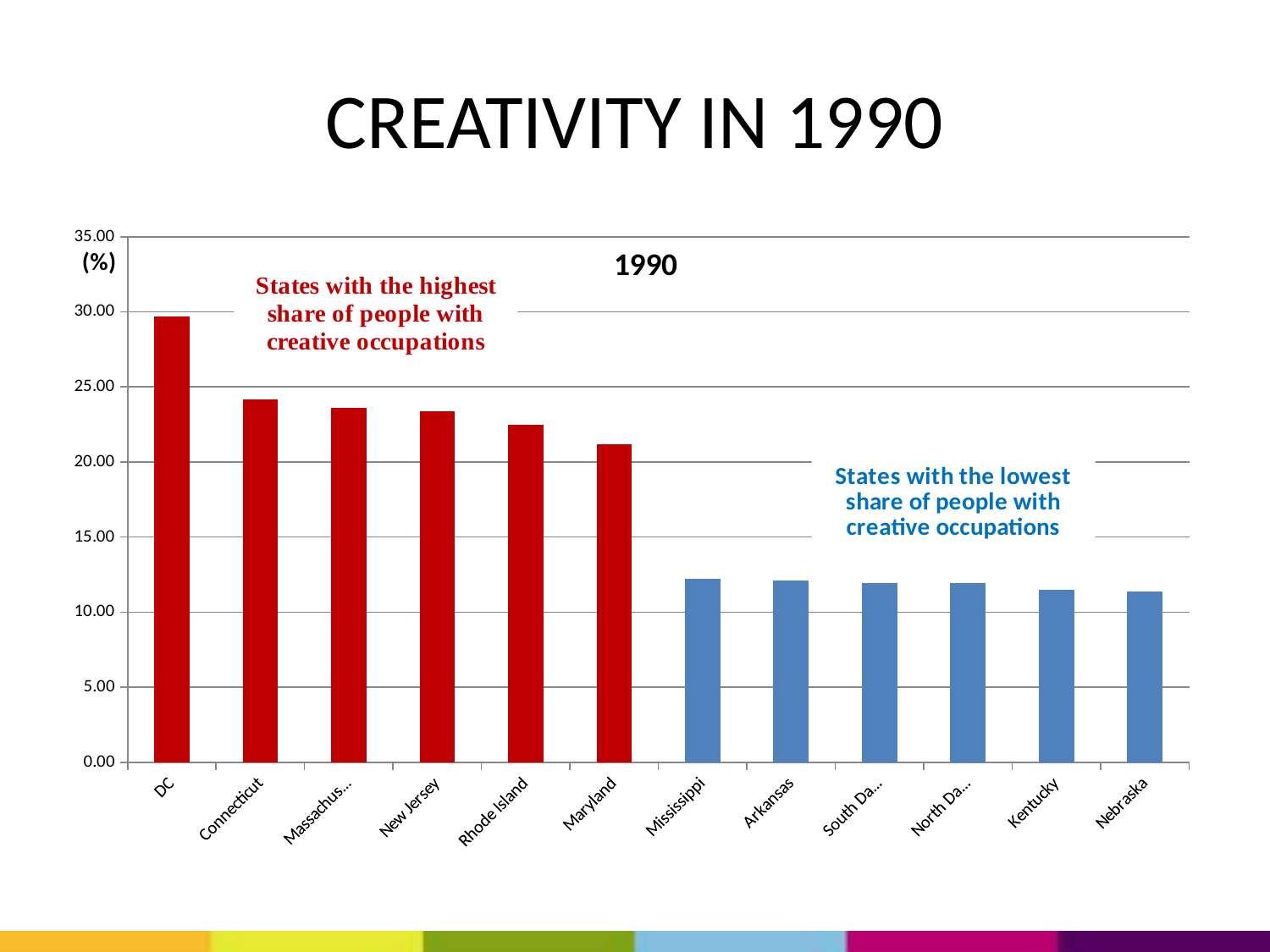
Among the red bars (states with the highest share), which state has the lowest value? Maryland Is the value for Connecticut greater or less than 25.00? less Do the bar values rise or fall moving from left to right along the x axis? fall Is the value for DC greater or less than 25.00? greater Is the value for Maryland greater or less than 20.00? greater What colour are the bars for the states with the lowest share of people with creative occupations? blue Which state has the highest share of people with creative occupations? DC Which is larger, the value for Maryland or the value for Mississippi? Maryland Which is larger, the value for DC or the value for Connecticut? DC What kind of chart is shown on the slide? bar chart How many states (categories) are plotted on the chart? 12